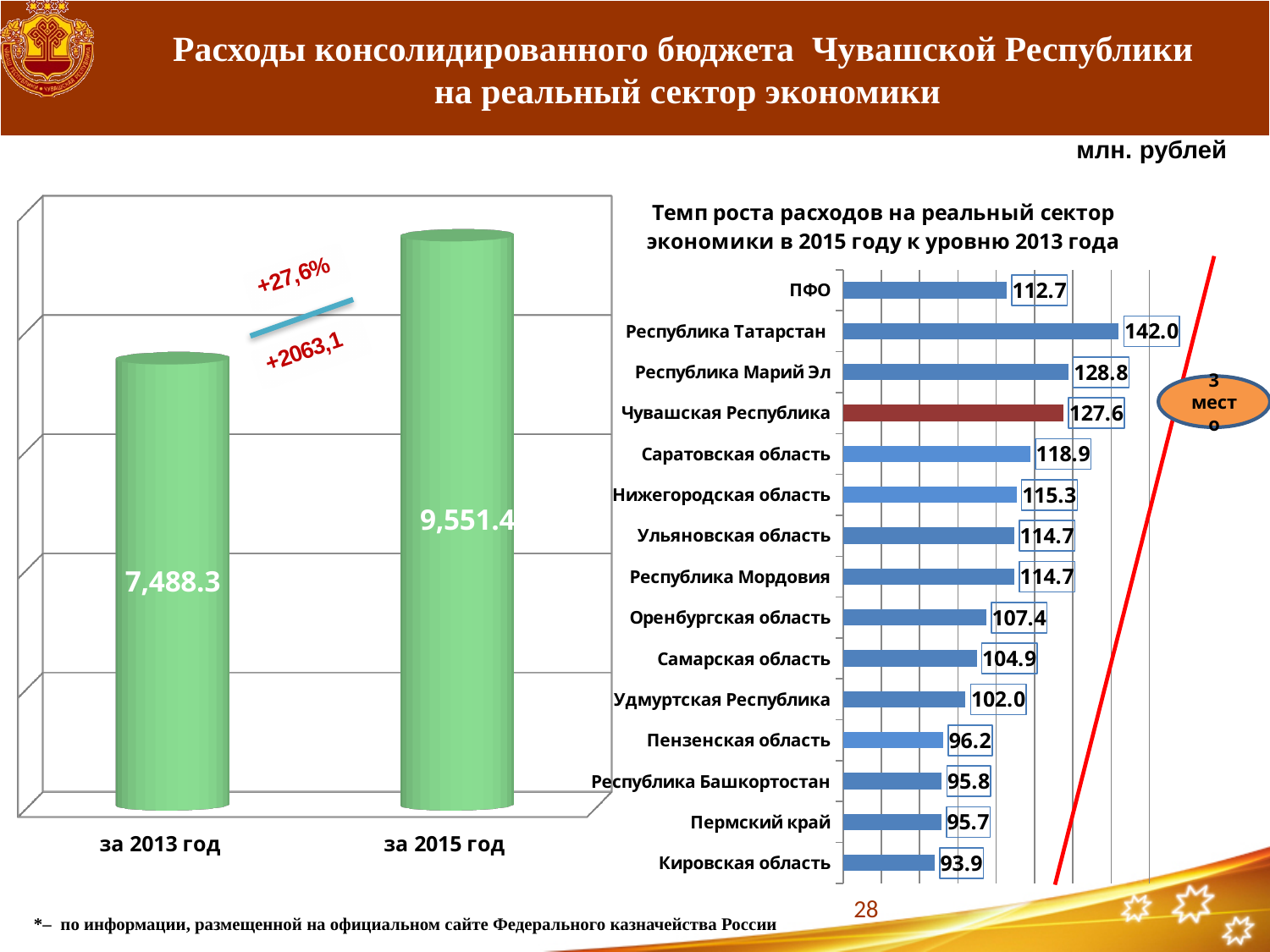
On the right chart, how many categories are plotted? 15 On the right chart, which bar is shown in a different colour (dark red) from the others? Чувашская Республика On the right chart, which region has the lowest value? Кировская область On the right chart, what is the difference between Республика Татарстан and Республика Марий Эл? 13.2 What kind of chart is the left chart? bar chart On the left chart, which year has the higher value, 2013 or 2015? за 2015 год On the right chart, which region has the highest value? Республика Татарстан On the left chart, what is the value for 2013 (за 2013 год)? 7,488.3 On the left chart, what is the value for 2015 (за 2015 год)? 9,551.4 On the right chart (Темп роста расходов на реальный сектор экономики), what is the value for Чувашская Республика? 127.6 On the right chart, what is the value for ПФО? 112.7 On the left chart, what is the difference between the 2015 and 2013 values? 2,063.1